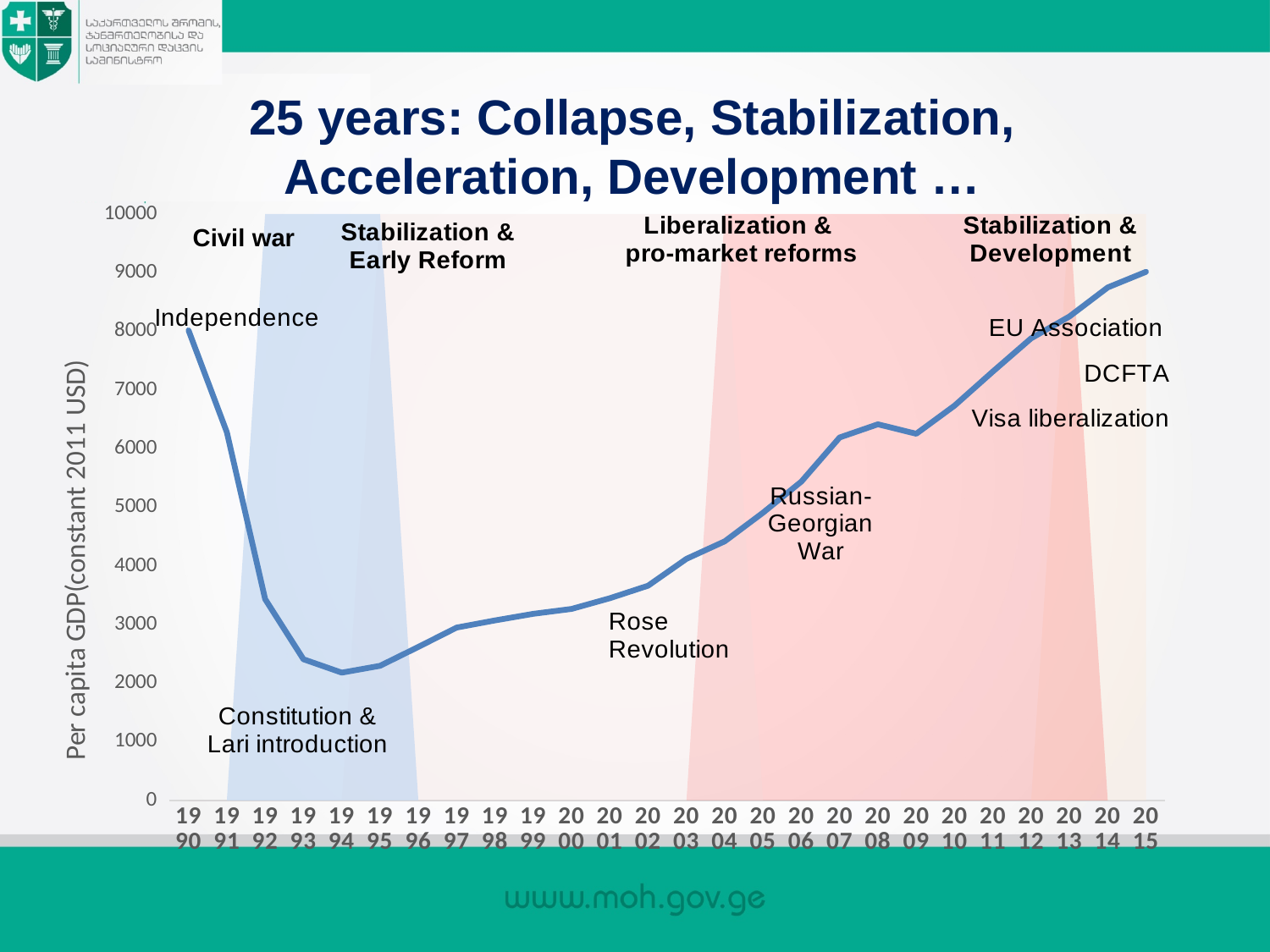
What is the label of the vertical axis of the chart? Per capita GDP(constant 2011 USD) Is the value for 2015 greater or less than 8000? greater What is the title of the slide containing the chart? 25 years: Collapse, Stabilization, Acceleration, Development … Which year has the higher per capita GDP, 1990 or 2015? 2015 Is the value for 1994 greater or less than 3000? less In which year is per capita GDP at its highest on the chart? 2015 How many years are plotted along the x axis of the chart? 26 What kind of chart is shown on the slide? line chart Is the value for 2008 greater or less than 6000? greater In which year is per capita GDP at its lowest on the chart? 1994 Does per capita GDP rise or fall between 1990 and 1994? fall